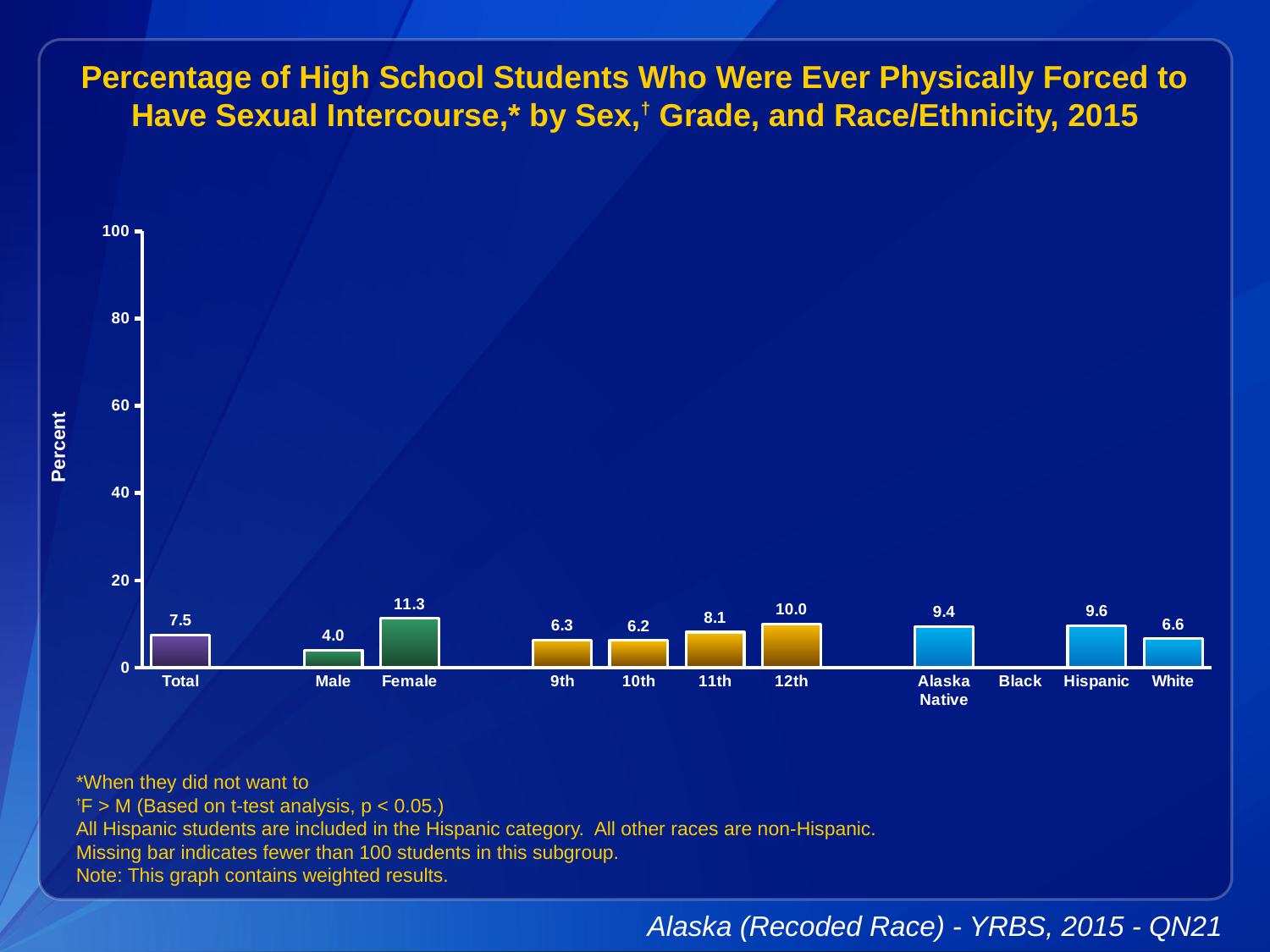
What is the value for Female? 11.3 Is the value for Alaska Native greater or less than 20? less Which category has no bar shown? Black Which category has the highest value? Female How many categories are labeled on the x axis? 11 Which category with a bar has the lowest value? Male Do the values rise or fall from 9th grade to 12th grade? rise Which is larger, the value for Hispanic or the value for White? Hispanic What kind of chart is this? bar chart What is the value for Total? 7.5 What is the difference between the Female and Male values? 7.3 What is the value for 12th grade? 10.0